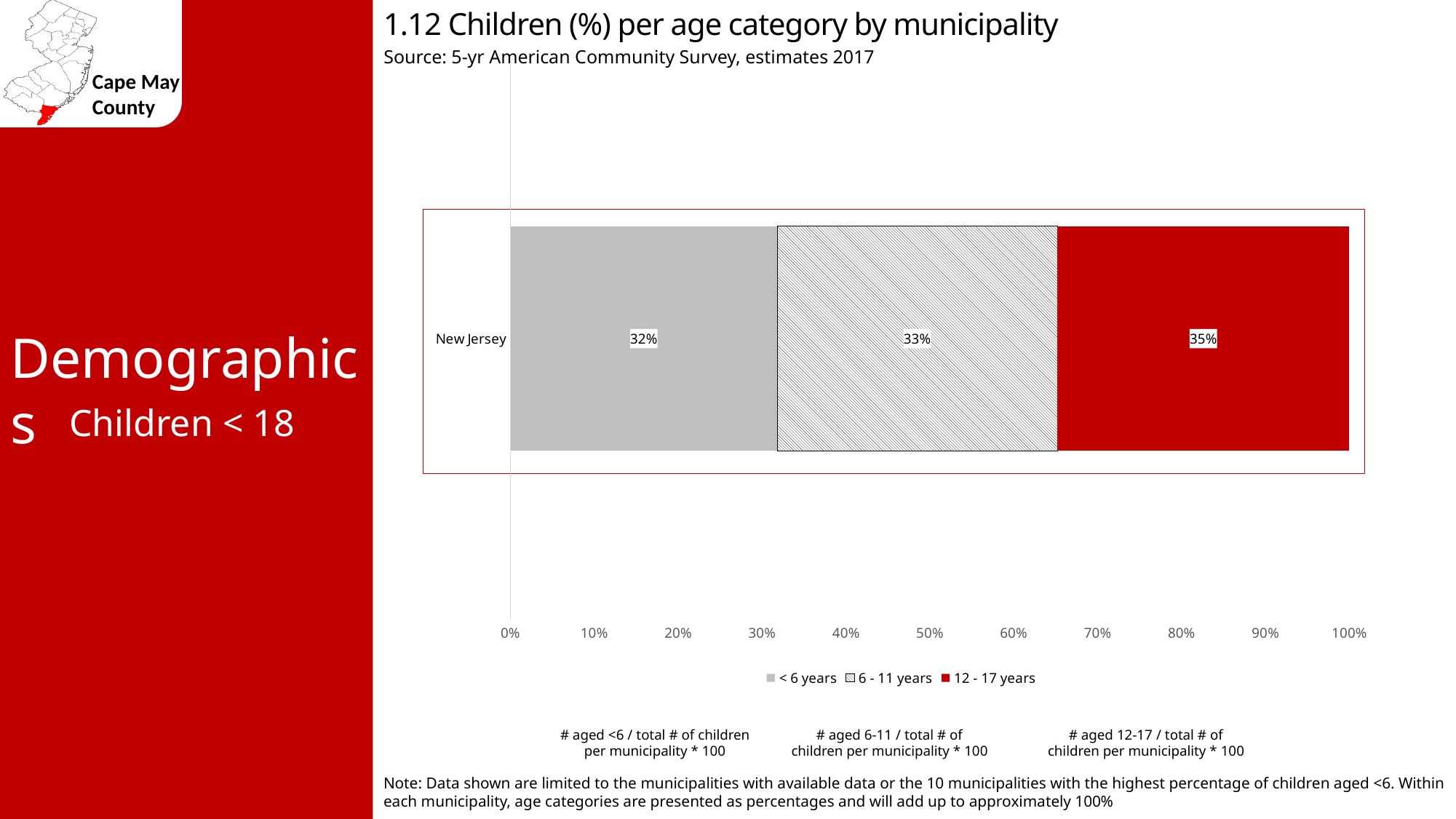
Which age category has the smallest share of children in New Jersey? < 6 years How many municipalities are plotted on the chart? 1 Is the share of children aged 12 - 17 years in New Jersey larger or smaller than the share aged 6 - 11 years? larger What percentage of children in New Jersey are aged under 6 years? 32% What percentage of children in New Jersey are aged 6 - 11 years? 33% Which age category has the largest share of children in New Jersey? 12 - 17 years What percentage of children in New Jersey are aged 12 - 17 years? 35% What kind of chart is shown on the slide? Stacked bar chart What is the title of the chart? 1.12 Children (%) per age category by municipality What is the total of the three age category percentages shown for New Jersey? 100% What is the difference between the 12 - 17 years share and the < 6 years share for New Jersey? 3% How many series does the legend list? 3